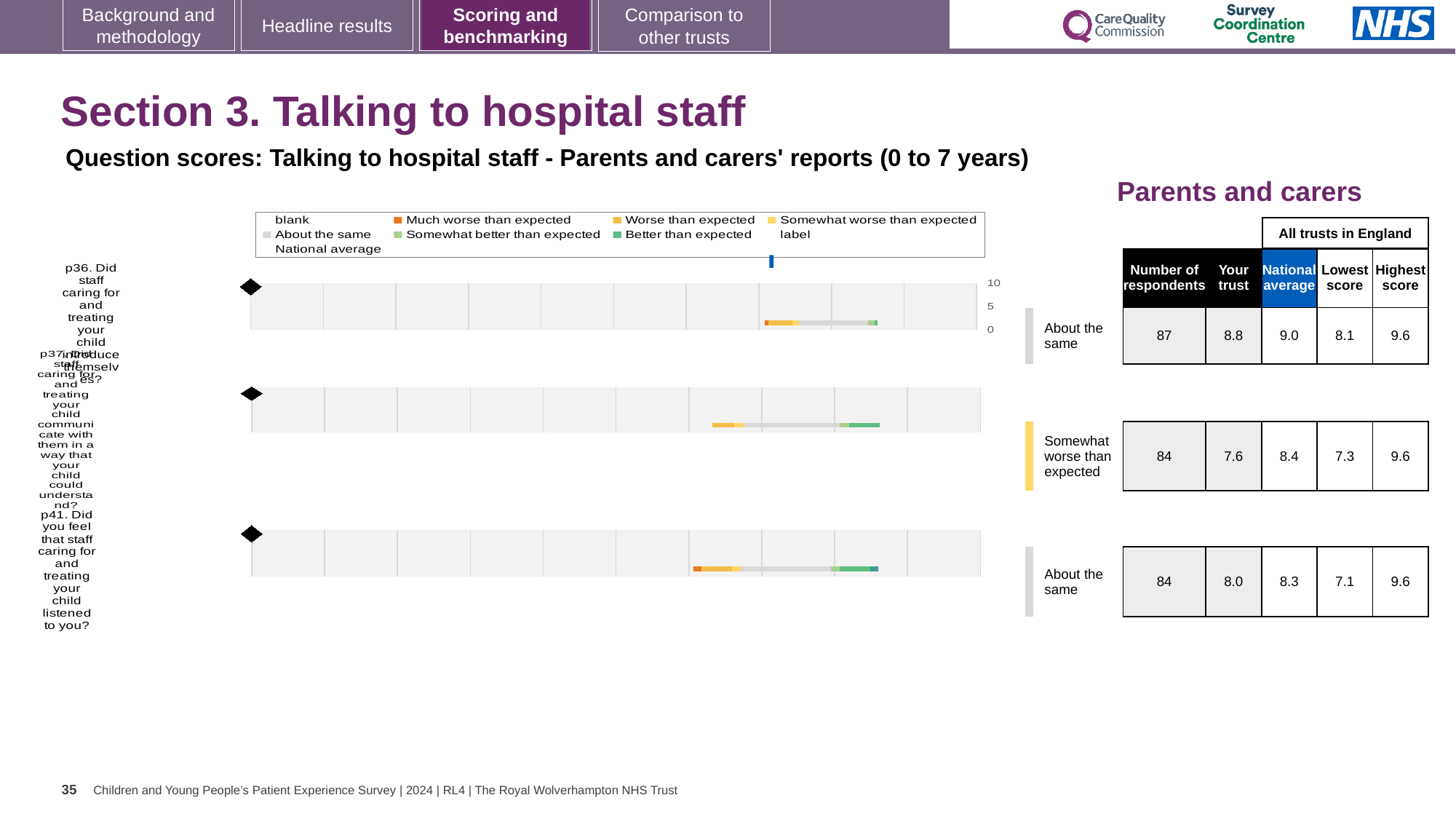
Which of the three questions has the highest 'Your trust' score? p36 What kind of chart is used to show the question scores on this slide? bar chart According to the table beside the chart, what is the 'Your trust' score for p36 (Did staff caring for and treating your child introduce themselves)? 8.8 According to the table beside the chart, what is the national average for p37 (Did staff communicate with them in a way your child could understand)? 8.4 According to the table beside the chart, what is the lowest score across all trusts in England for p41? 7.1 Which is larger: the 'Your trust' score for p36 or for p37? p36 What is the difference between the national average and the 'Your trust' score for p36? 0.2 What benchmark category is given for p37 next to the chart? Somewhat worse than expected According to the table beside the chart, how many respondents answered p41 (Did you feel that staff listened to you)? 84 How many questions (bars) are plotted in the chart? 3 What is the maximum value shown on the chart's score axis? 10 Which of the three questions has the lowest 'Your trust' score? p37